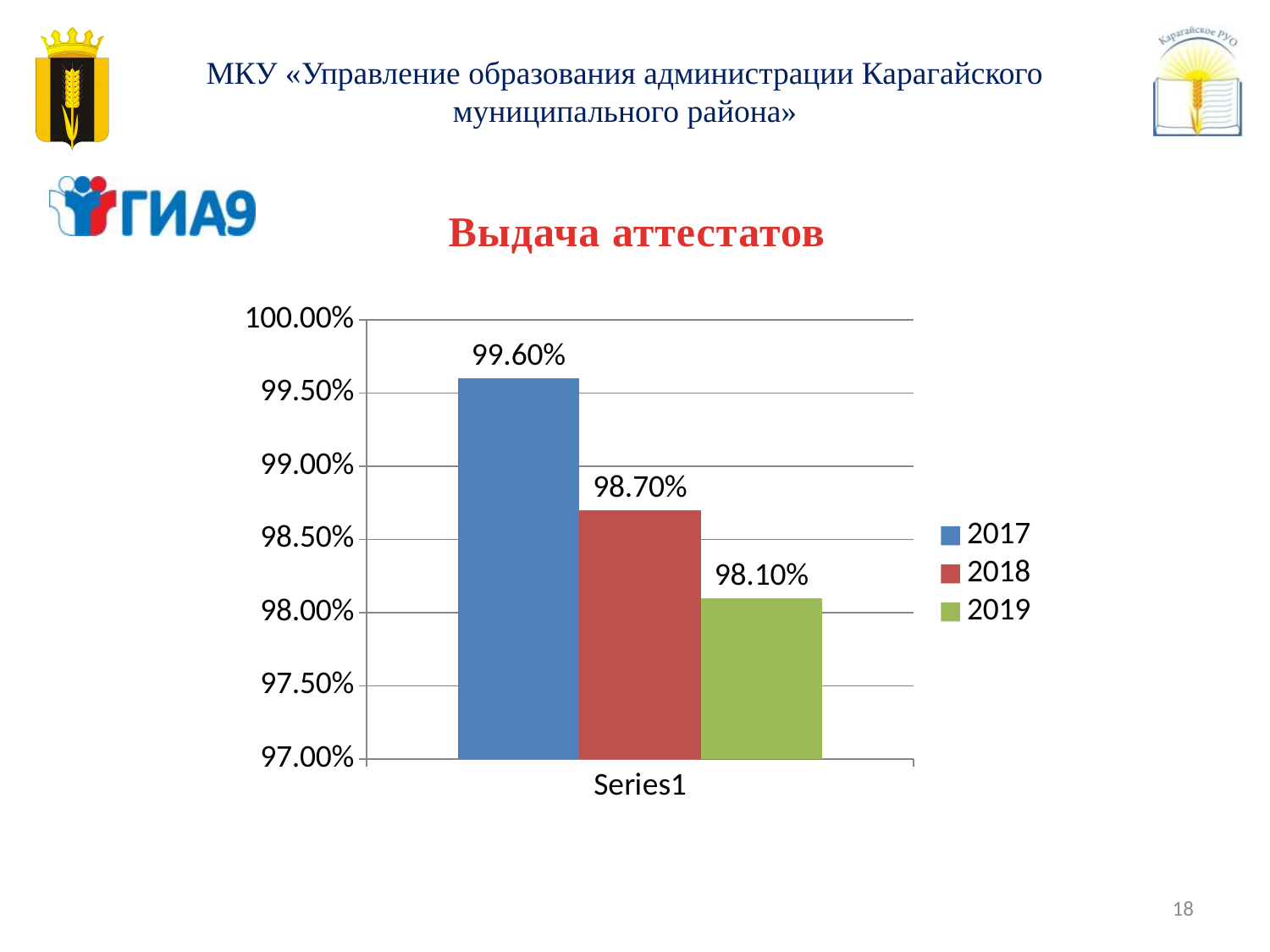
What kind of chart is shown on the slide? bar chart What is the value for 2017? 99.60% What is the value for 2019? 98.10% Is the value for 2018 greater or less than 99.00%? less Do the values rise or fall from 2017 to 2019? fall What is the difference between the values for 2017 and 2019? 1.50% Which year has the lowest value? 2019 Which year has the highest value? 2017 What is the value for 2018? 98.70% How many series does the legend list? 3 What is the difference between the values for 2018 and 2019? 0.60% Which is larger, the value for 2018 or the value for 2019? 2018